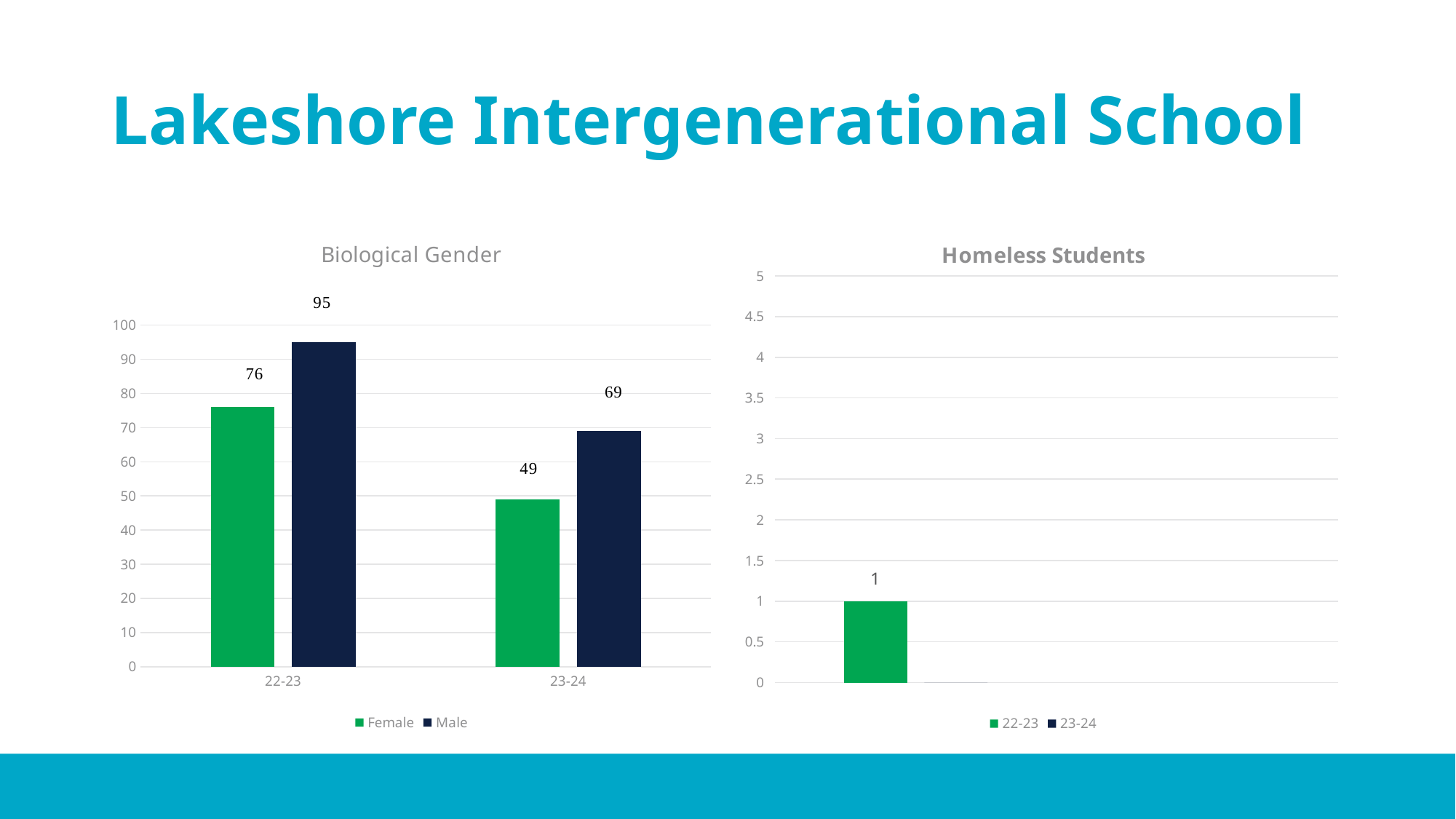
In the Biological Gender chart, which is larger: Female in 22-23 or Male in 23-24? Female in 22-23 In the Biological Gender chart, does the Male value rise or fall from 22-23 to 23-24? fall In the Biological Gender chart, how many series does the legend list? 2 In the Biological Gender chart, what is the value for Male in 22-23? 95 In the Homeless Students chart, how many series does the legend list? 2 In the Biological Gender chart, what is the value for Female in 23-24? 49 In the Homeless Students chart, what is the value for 22-23? 1 In the Biological Gender chart, which bar has the lowest value? Female, 23-24 In the Biological Gender chart, which bar has the highest value? Male, 22-23 What kind of chart is the Homeless Students chart? bar chart In the Biological Gender chart, what is the difference between Male and Female in 23-24? 20 In the Biological Gender chart, what is the value for Female in 22-23? 76